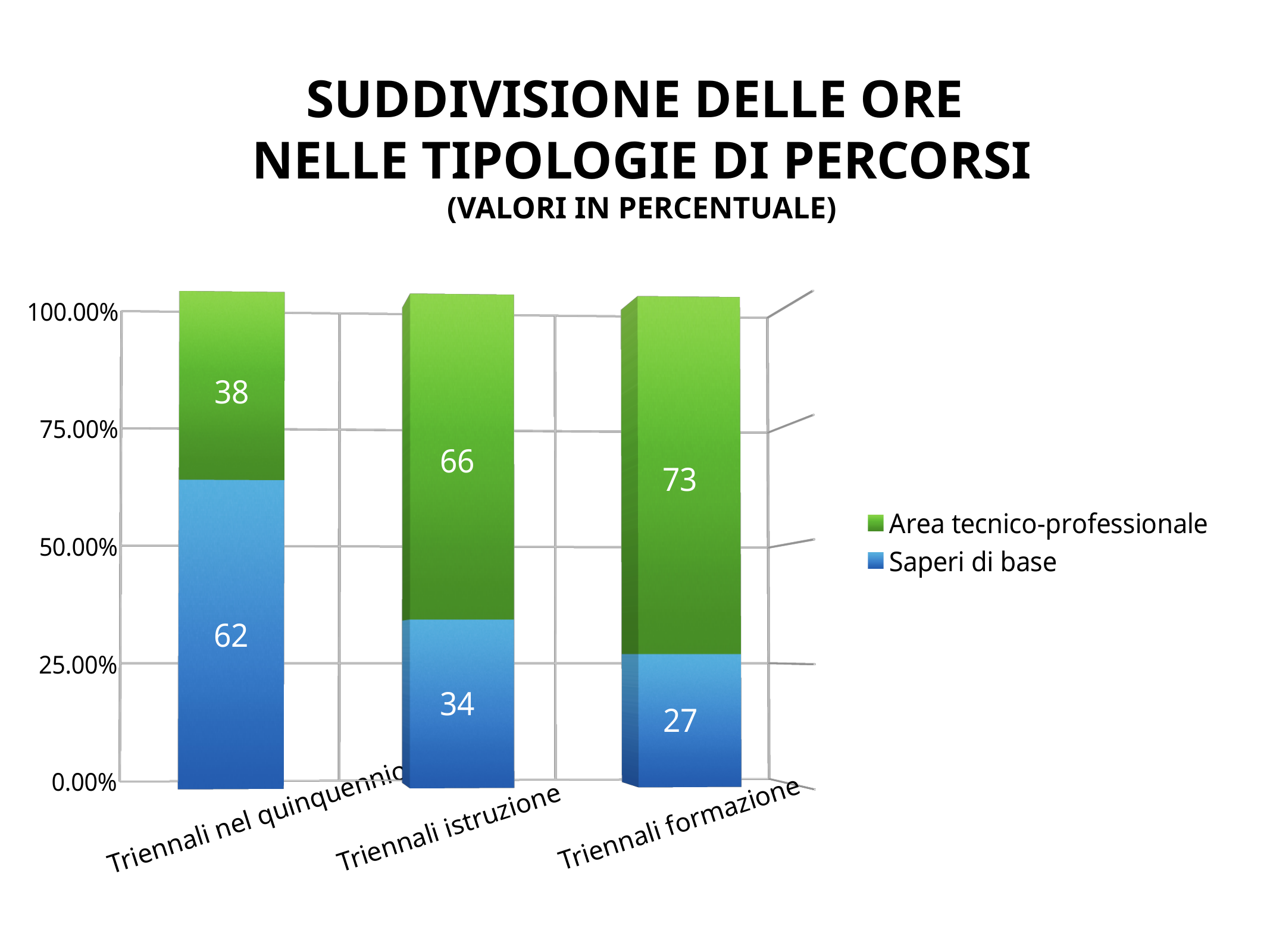
Which is larger: Area tecnico-professionale in Triennali nel quinquennio or Saperi di base in Triennali nel quinquennio? Saperi di base Which category has the highest value for Area tecnico-professionale? Triennali formazione How many categories are shown on the x axis? 3 How many series does the legend list? 2 What kind of chart is shown on the slide? Stacked bar chart What is the value for Area tecnico-professionale in Triennali istruzione? 66 What is the value for Saperi di base in Triennali nel quinquennio? 62 What is the value for Saperi di base in Triennali formazione? 27 Which category has the lowest value for Saperi di base? Triennali formazione Does the Saperi di base value rise or fall from Triennali nel quinquennio to Triennali formazione? Fall What is the value for Area tecnico-professionale in Triennali formazione? 73 What is the difference between the Saperi di base values for Triennali nel quinquennio and Triennali istruzione? 28